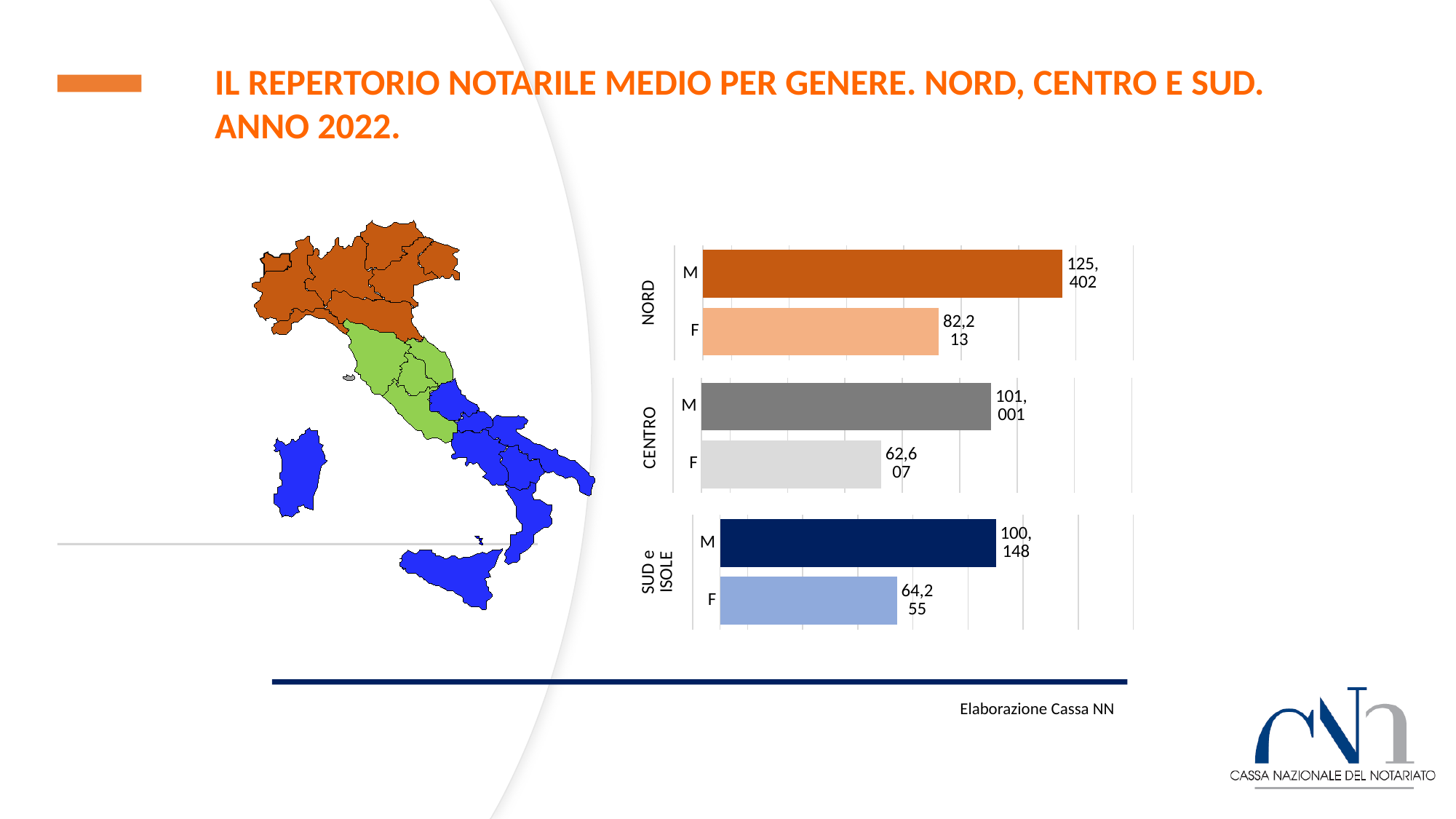
What is the difference between the M and F values in the NORD group? 43,189 What is the value for F in the SUD e ISOLE group? 64,255 Which is larger, the F value for NORD or the F value for SUD e ISOLE? NORD F How many geographic groups are shown in the chart? 3 What is the value for F in the NORD group? 82,213 What is the value for M in the SUD e ISOLE group? 100,148 What type of chart is shown on the slide? bar chart Which bar has the lowest value in the chart? CENTRO F What is the value for M in the CENTRO group? 101,001 Which bar has the highest value in the chart? NORD M What is the value for M in the NORD group? 125,402 What is the value for F in the CENTRO group? 62,607